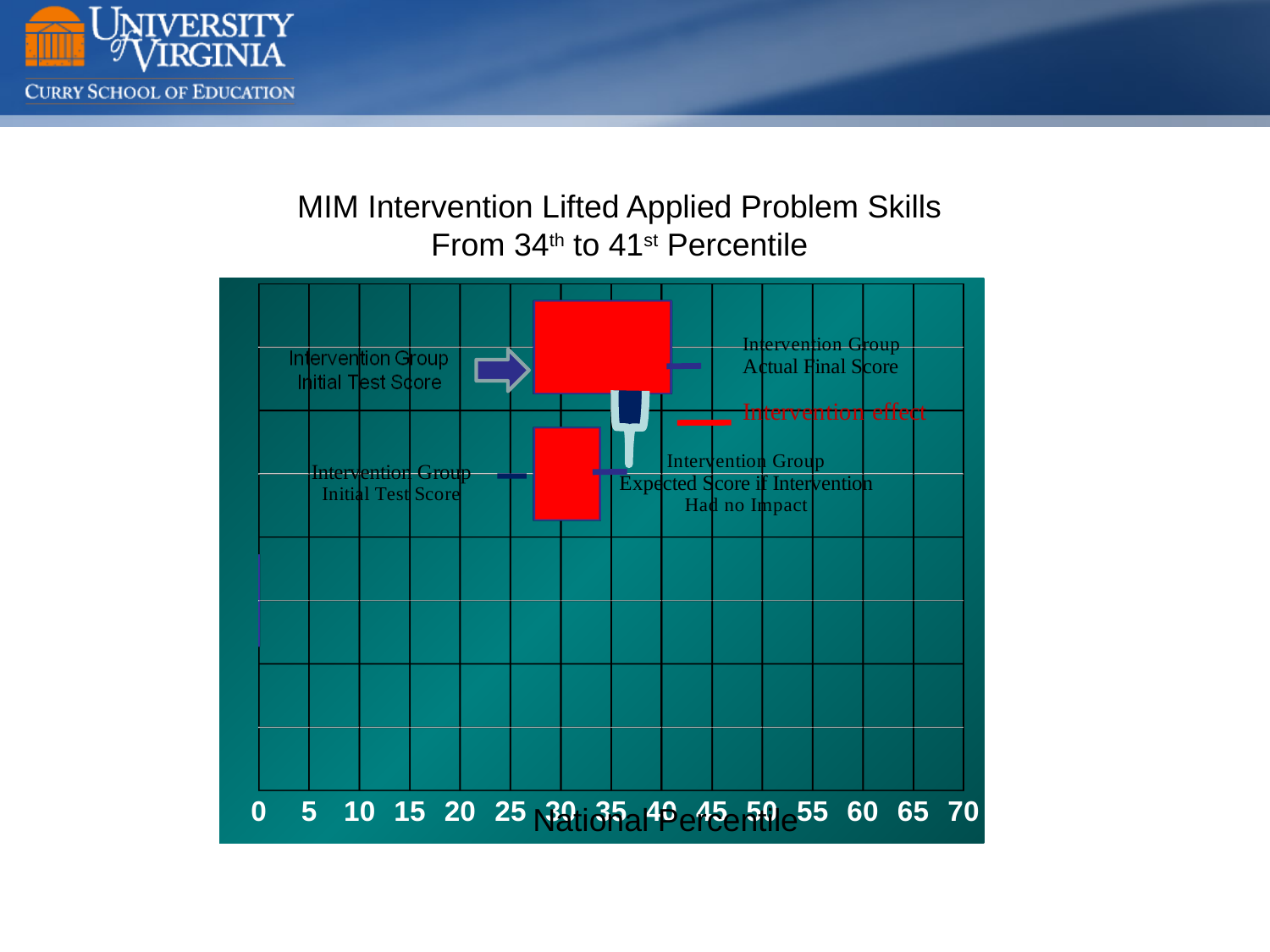
What is the title of the chart? MIM Intervention Lifted Applied Problem Skills From 34th to 41st Percentile Is the Intervention Group Expected Score if Intervention Had no Impact greater or less than 40 on the National Percentile axis? less How many tick labels are shown on the National Percentile axis? 15 Is the Intervention Group Actual Final Score greater or less than 35 on the National Percentile axis? greater What is the interval between consecutive tick labels on the National Percentile axis? 5 What is the highest value shown on the National Percentile axis? 70 According to the chart title, at what percentile did the intervention group's applied problem skills end? 41st According to the chart title, at what percentile did the intervention group's applied problem skills start? 34th By how many percentile points did the MIM intervention lift applied problem skills, according to the title? 7 What is the label of the x axis? National Percentile Which is larger, the intervention group's initial percentile or its final percentile? Final percentile What kind of chart is shown on the slide? Bar chart